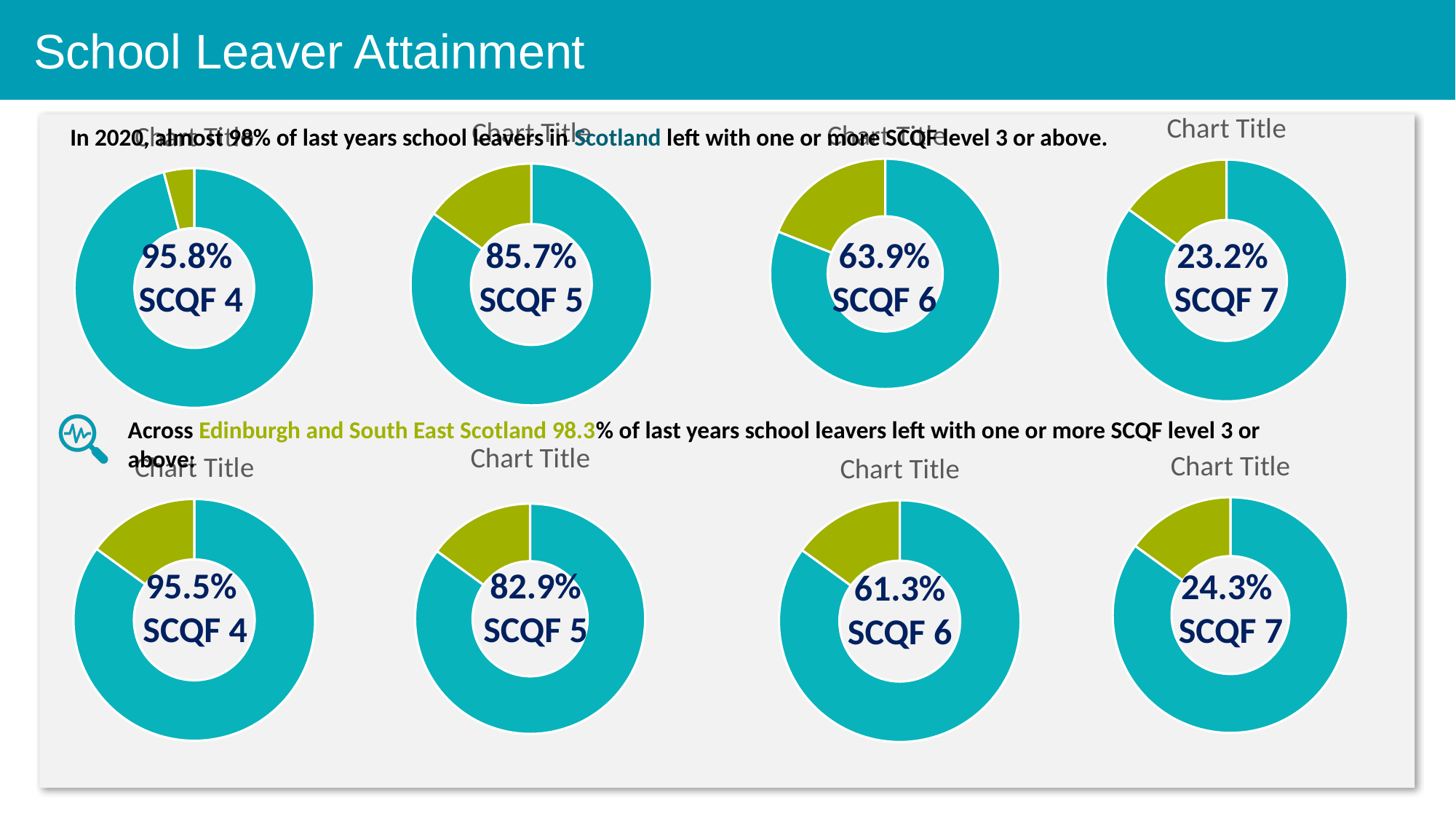
In the bottom-row chart labelled SCQF 5, what percentage is shown? 82.9% Among the bottom-row charts, which SCQF level shows the highest percentage? SCQF 4 In the top-row chart labelled SCQF 7, what percentage is shown? 23.2% What is the title shown above each of the donut charts? Chart Title In the bottom-row chart labelled SCQF 6, what percentage is shown? 61.3% How many donut charts are on the slide? 8 Which is larger: the SCQF 7 percentage in the top-row chart or the SCQF 7 percentage in the bottom-row chart? Bottom-row chart (24.3%) What kind of chart is used for each SCQF level on the slide? Donut (pie) chart Among the top-row charts, which SCQF level shows the lowest percentage? SCQF 7 What is the difference between the SCQF 5 percentage in the top row (85.7%) and the SCQF 5 percentage in the bottom row (82.9%)? 2.8% In the top-row chart labelled SCQF 4, what percentage is shown? 95.8% Reading the top-row charts from SCQF 4 to SCQF 7, do the printed percentages rise or fall? Fall